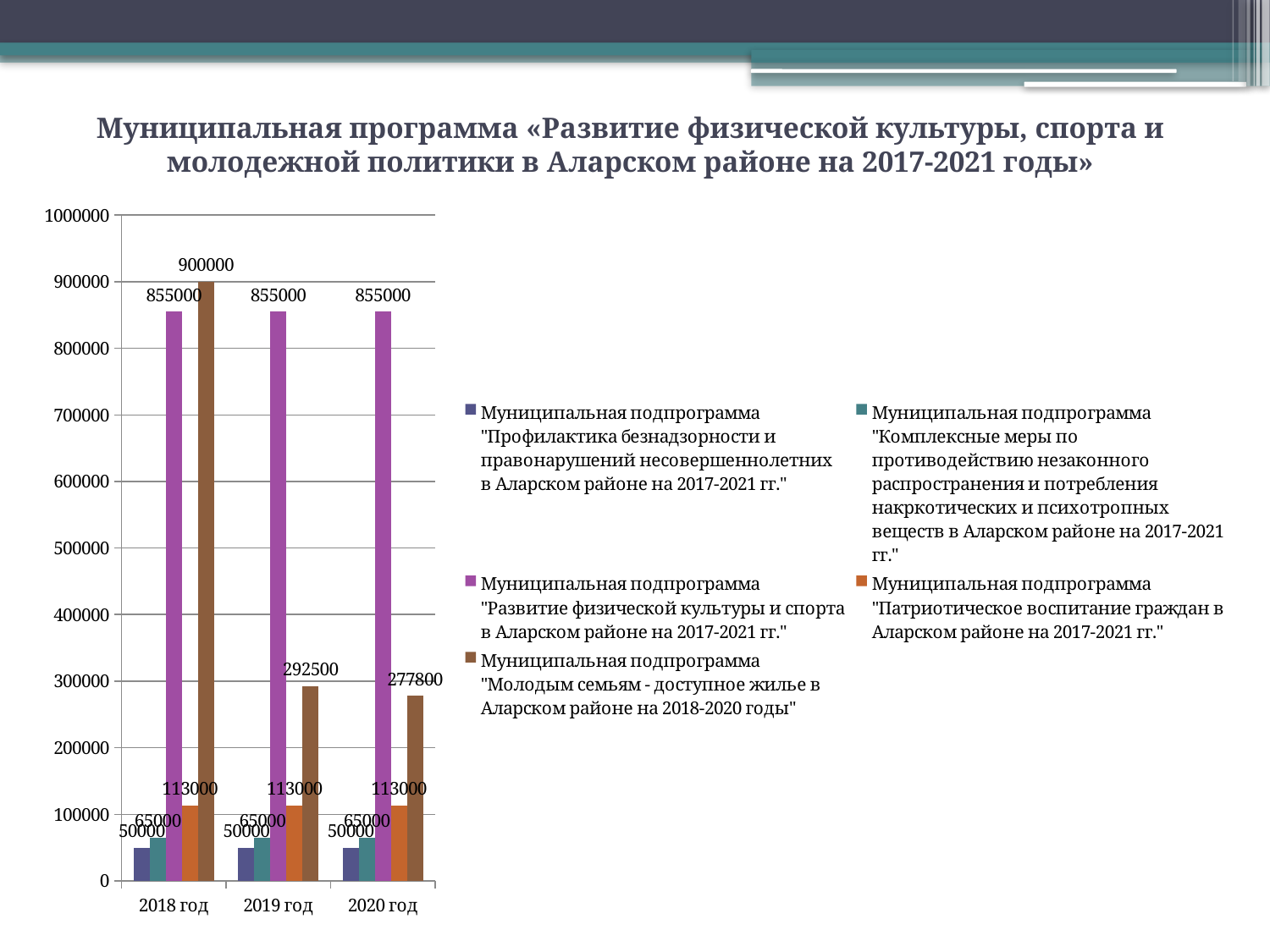
What is the value for the subprogram "Развитие физической культуры и спорта" in 2020 год? 855000 Does the value for "Молодым семьям - доступное жилье" rise or fall from 2018 год to 2020 год? fall What is the value for the subprogram "Молодым семьям - доступное жилье" in 2020 год? 277800 Which is larger in 2018 год: the value for "Молодым семьям - доступное жилье" or for "Развитие физической культуры и спорта"? Молодым семьям - доступное жилье What is the difference between the "Молодым семьям - доступное жилье" values in 2018 год and 2019 год? 607500 What is the value for the subprogram "Патриотическое воспитание граждан" in 2019 год? 113000 What is the value for the subprogram "Молодым семьям - доступное жилье" in 2019 год? 292500 How many year categories are shown on the x axis? 3 How many series does the legend list? 5 Which year has the highest value for the subprogram "Молодым семьям - доступное жилье"? 2018 год What is the value for the subprogram "Молодым семьям - доступное жилье" in 2018 год? 900000 What type of chart is shown on the slide? bar chart